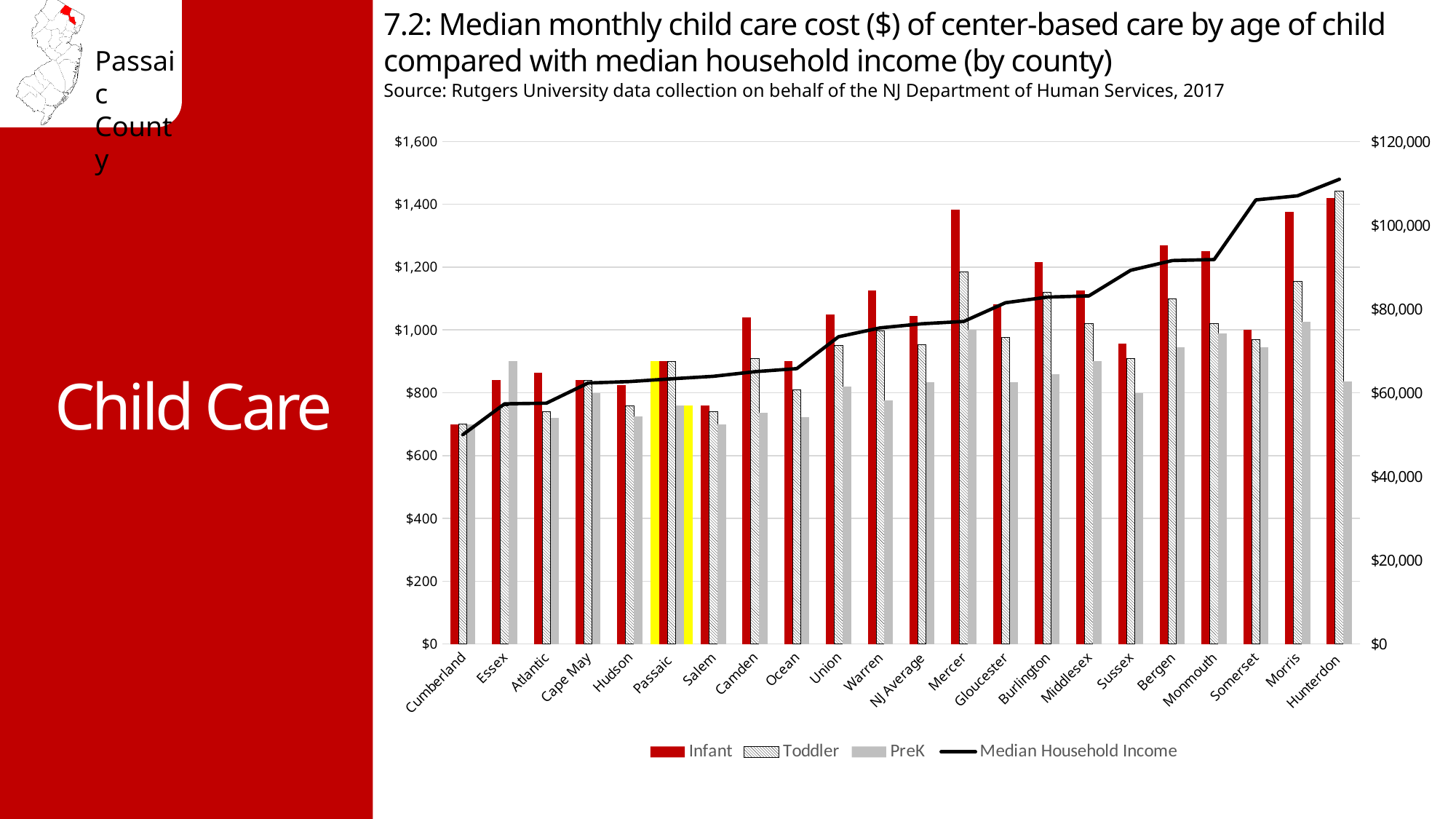
Is the Median Household Income for Hunterdon greater or less than $100,000? greater How many series does the legend list? 4 Which county has the highest Infant child care cost? Hunterdon Does the Median Household Income line generally rise or fall from Cumberland to Hunterdon? rise Which is larger for Essex, the Infant cost or the PreK cost? PreK Is the Infant cost for Cumberland greater or less than $800? less Which county has the lowest Infant child care cost? Cumberland Which county has the highest Toddler child care cost? Hunterdon Is the Median Household Income for Cumberland greater or less than $60,000? less How many counties (including NJ Average) are shown on the x axis? 22 Which county's bars are highlighted in yellow? Passaic